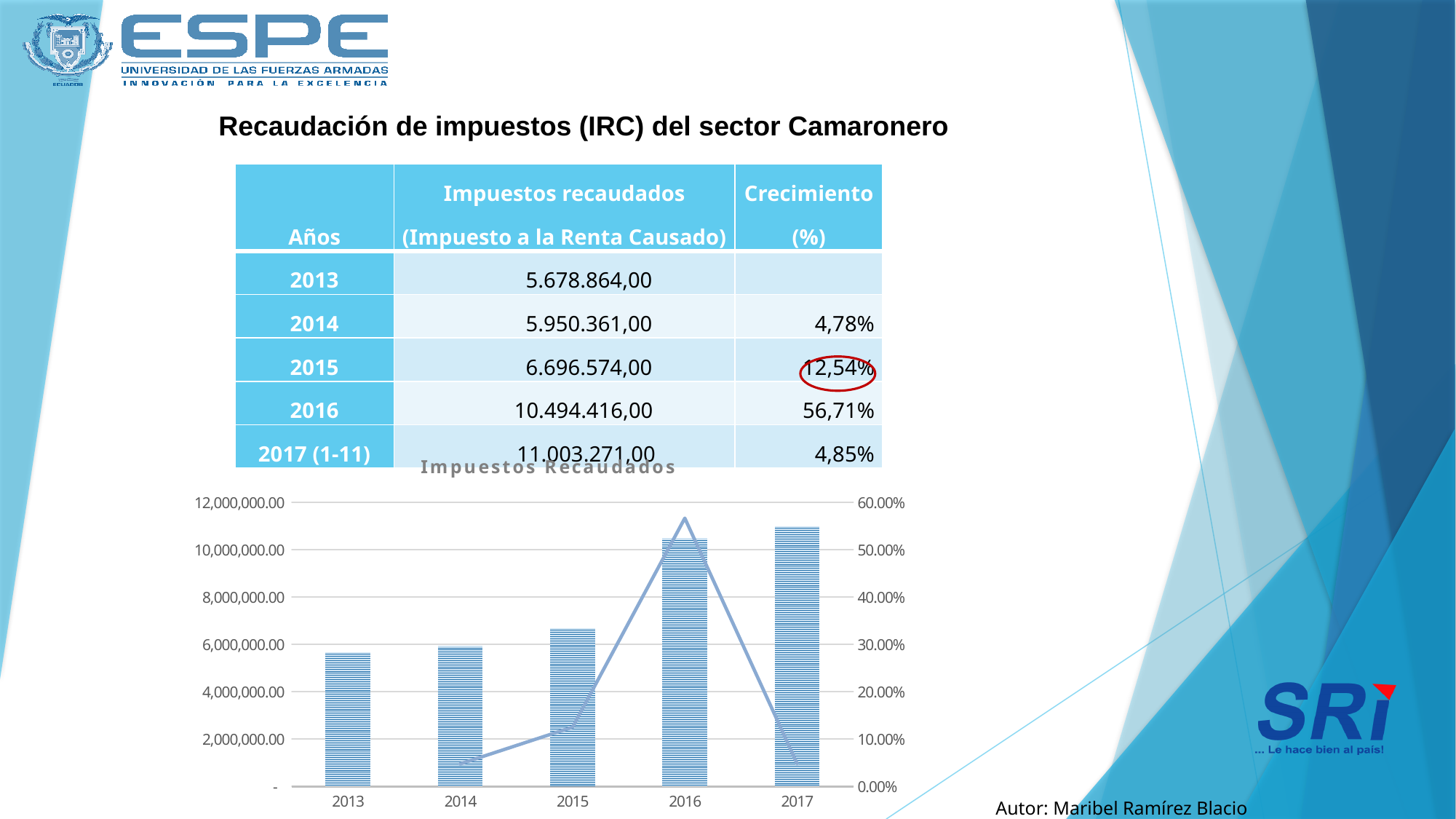
According to the table, what were the taxes collected (Impuesto a la Renta Causado) in 2016? 10.494.416,00 What is the title of the chart? Impuestos Recaudados Is the line value for 2016 greater or less than 50.00% on the right axis? greater In which year does the line (growth %) reach its peak? 2016 What kind of chart is shown on the slide? bar chart with a line How many years are plotted as bars in the chart? 5 Which year has the shortest bar in the chart? 2013 Is the bar for 2016 greater or less than 10,000,000.00? greater Which year has the tallest bar in the chart? 2017 Is the bar for 2015 greater or less than 8,000,000.00? less Do the bars rise or fall from 2013 to 2017? rise Which bar is taller, 2014 or 2015? 2015